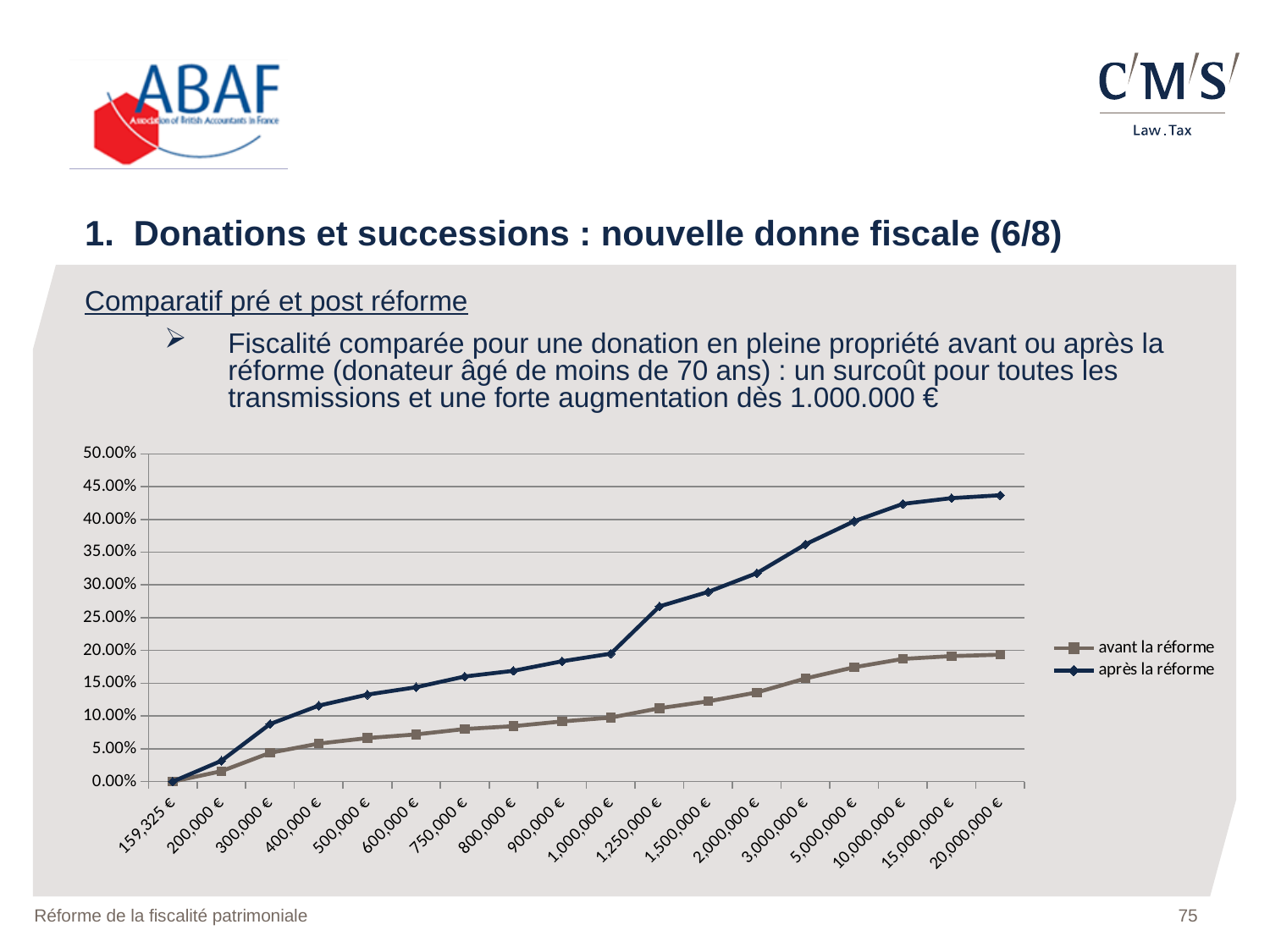
Is the value for 'après la réforme' at 2,000,000 € greater or less than 30%? greater At 1,000,000 €, which series has the larger value, 'avant la réforme' or 'après la réforme'? après la réforme What kind of chart is shown on the slide? line chart What is the first category on the x axis? 159,325 € Do the values for 'après la réforme' rise or fall as the amount increases along the x axis? rise Which series is drawn in dark blue with diamond markers? après la réforme How many series does the legend list? 2 Is the value for 'après la réforme' at 1,250,000 € greater or less than 25%? greater Is the value for 'après la réforme' at 20,000,000 € greater or less than 40%? greater How many categories are shown on the x axis? 18